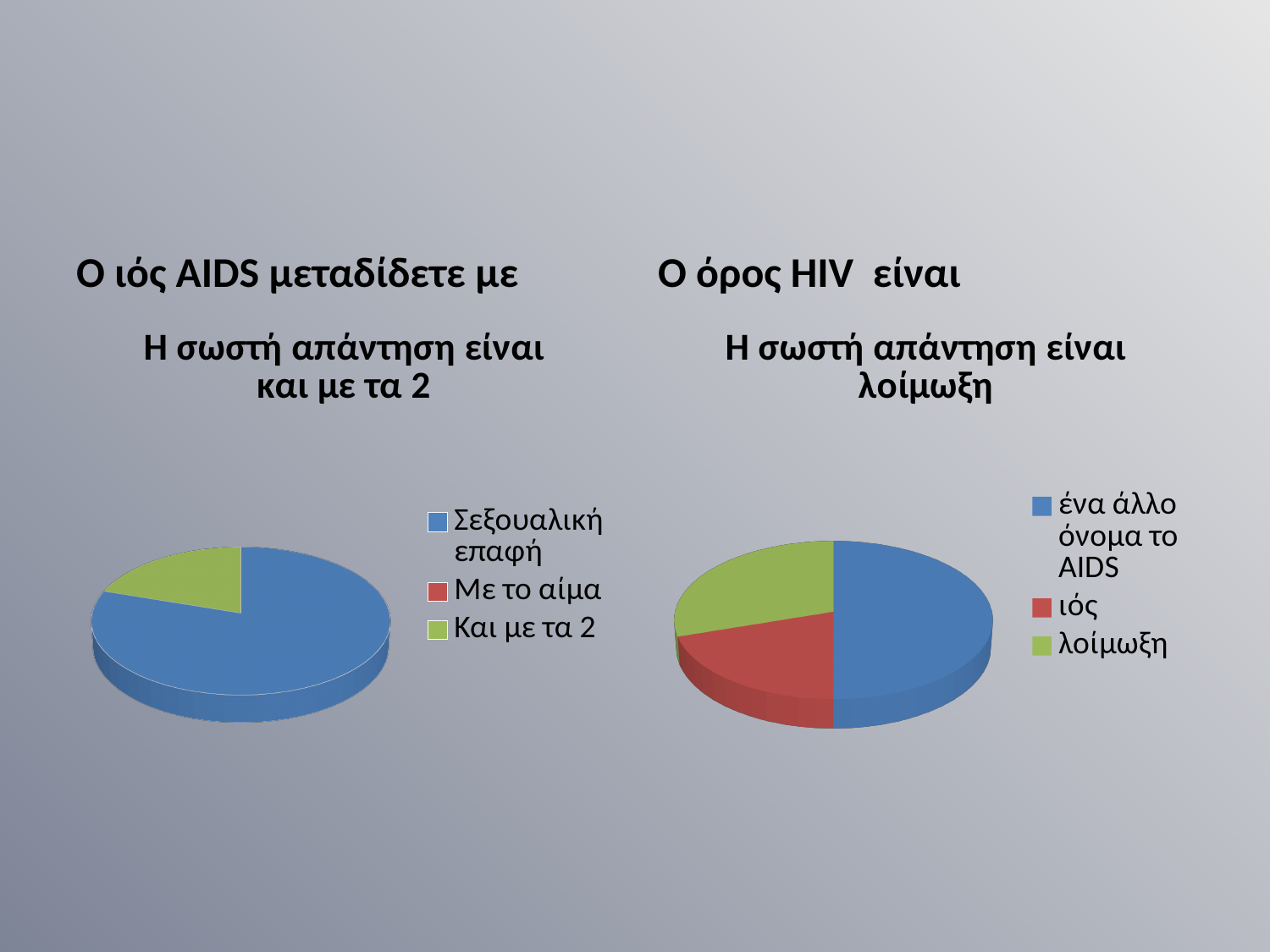
In the left chart, titled 'Η σωστή απάντηση είναι και με τα 2', how many categories does the legend list? 3 What kind of chart is the left chart, titled 'Η σωστή απάντηση είναι και με τα 2'? pie chart In the left chart, titled 'Η σωστή απάντηση είναι και με τα 2', what colour represents 'Και με τα 2'? green In the left chart, titled 'Η σωστή απάντηση είναι και με τα 2', which category has the largest slice? Σεξουαλική επαφή In the right chart, titled 'Η σωστή απάντηση είναι λοίμωξη', which slice is larger: 'ένα άλλο όνομα το AIDS' or 'λοίμωξη'? ένα άλλο όνομα το AIDS In the right chart, titled 'Η σωστή απάντηση είναι λοίμωξη', what colour represents 'ιός'? red In the left chart, titled 'Η σωστή απάντηση είναι και με τα 2', which slice is larger: 'Σεξουαλική επαφή' or 'Και με τα 2'? Σεξουαλική επαφή In the right chart, titled 'Η σωστή απάντηση είναι λοίμωξη', which category has the largest slice? ένα άλλο όνομα το AIDS In the right chart, titled 'Η σωστή απάντηση είναι λοίμωξη', how many categories does the legend list? 3 In the right chart, titled 'Η σωστή απάντηση είναι λοίμωξη', which slice is larger: 'ένα άλλο όνομα το AIDS' or 'ιός'? ένα άλλο όνομα το AIDS What kind of chart is the right chart, titled 'Η σωστή απάντηση είναι λοίμωξη'? pie chart